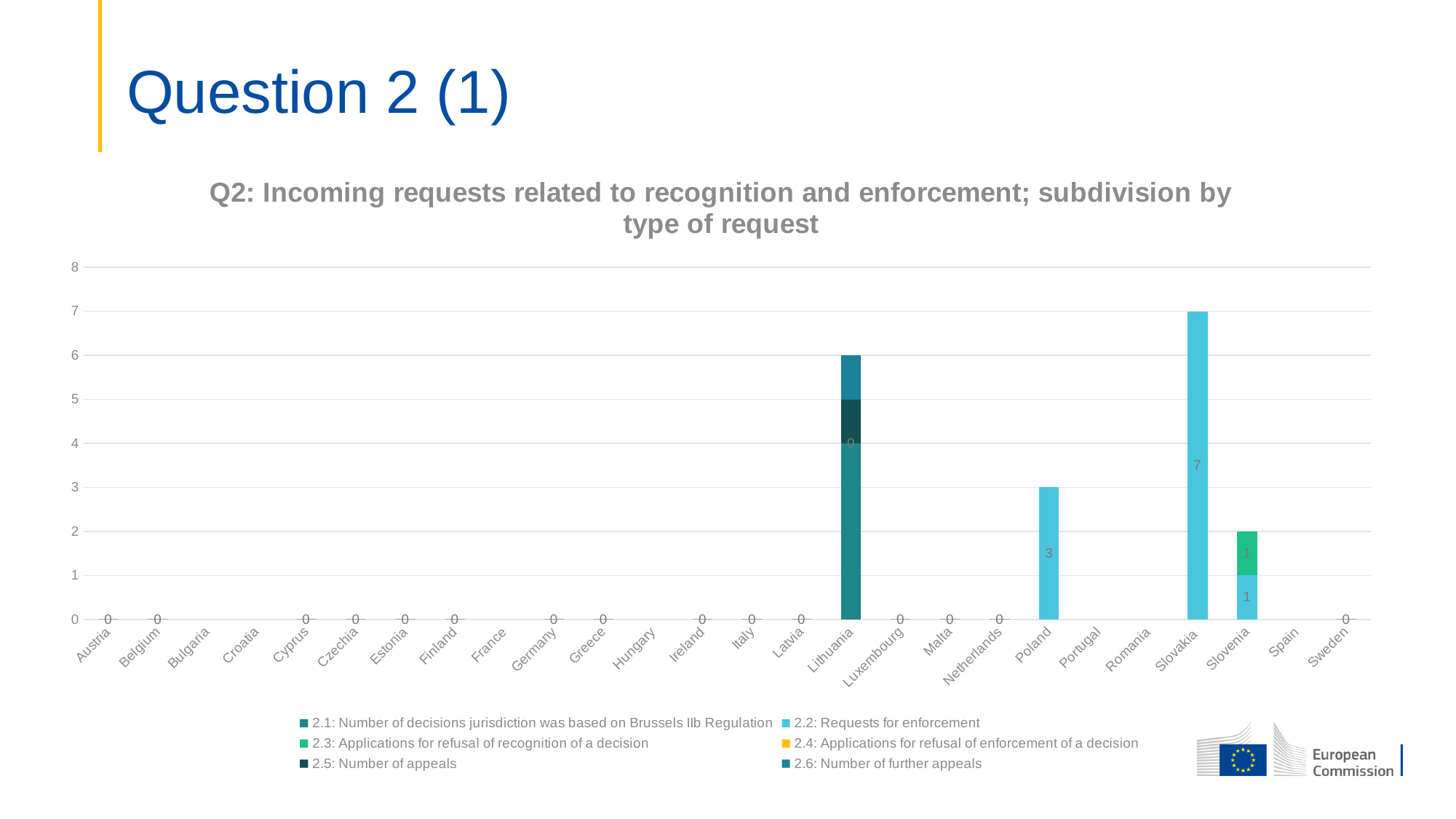
How many series does the legend list? 6 Is the total height of the stacked bar for Lithuania greater or less than 5? greater How many countries are shown on the x axis? 26 What kind of chart is shown on the slide? Stacked bar chart Which has a larger value for 2.2: Requests for enforcement, Poland or Slovenia? Poland What is the difference between the 2.2: Requests for enforcement values for Slovakia and Poland? 4 What is the value of 2.3: Applications for refusal of recognition of a decision for Slovenia? 1 What is the title of the chart? Q2: Incoming requests related to recognition and enforcement; subdivision by type of request Which country has the tallest stacked bar? Slovakia What is the value of 2.2: Requests for enforcement for Poland? 3 What is the value of 2.2: Requests for enforcement for Slovakia? 7 What is the total height of the stacked bar for Slovenia? 2